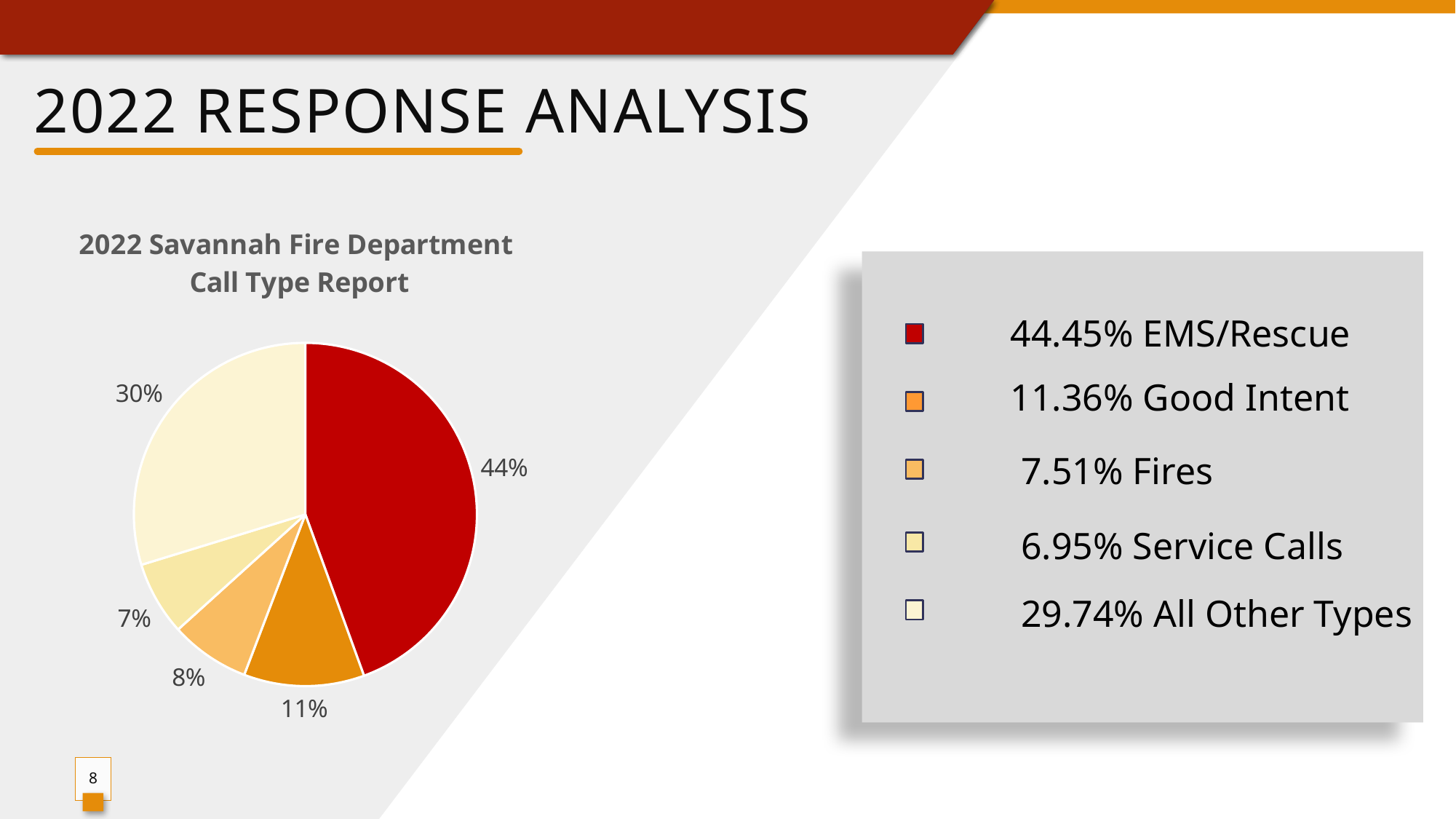
Which call type has the smallest slice of the pie? Service Calls Using the pie labels, what is the difference between the EMS/Rescue slice and the All Other Types slice? 14% What kind of chart is shown on the slide? pie chart What is the title of the chart? 2022 Savannah Fire Department Call Type Report How many slices does the pie chart have? 5 Which call type has the largest slice of the pie? EMS/Rescue According to the legend, what share of calls is Good Intent? 11.36% According to the legend, what share of calls is Service Calls? 6.95% What percentage label is shown on the pie slice for All Other Types? 30% What percentage label is shown on the pie slice for EMS/Rescue? 44% According to the legend, what share of calls is Fires? 7.51% Which is larger, the Good Intent slice or the Fires slice? Good Intent